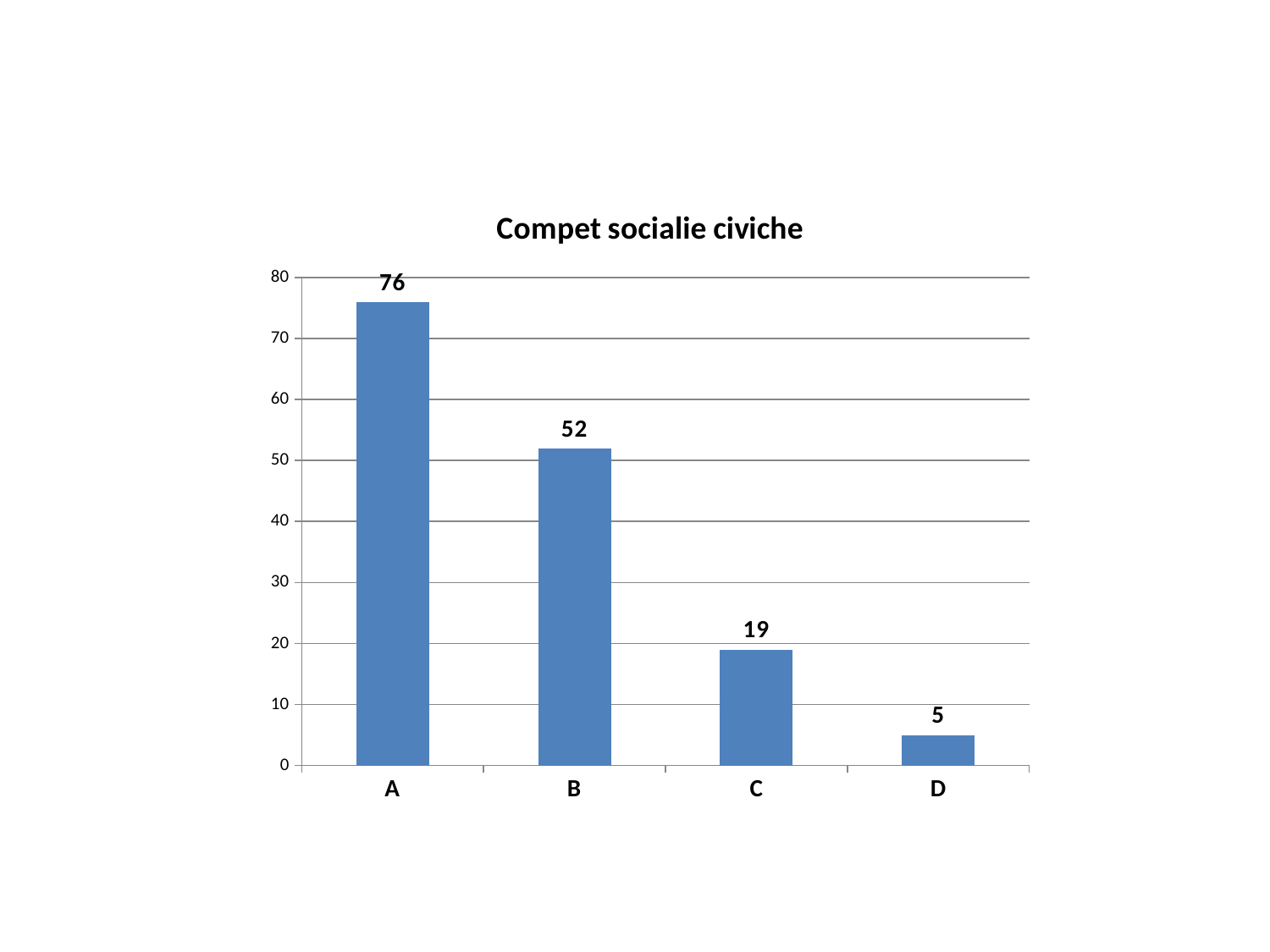
What is the difference between the values for C and D? 14 Which category has the lowest value? D What is the value for category A? 76 What is the value for category B? 52 What is the value for category C? 19 What is the title of the chart? Compet socialie civiche What is the difference between the values for A and B? 24 What is the value for category D? 5 What kind of chart is shown? Bar chart How many categories are shown on the x axis? 4 Which is larger, the value for B or the value for C? B Which category has the highest value? A